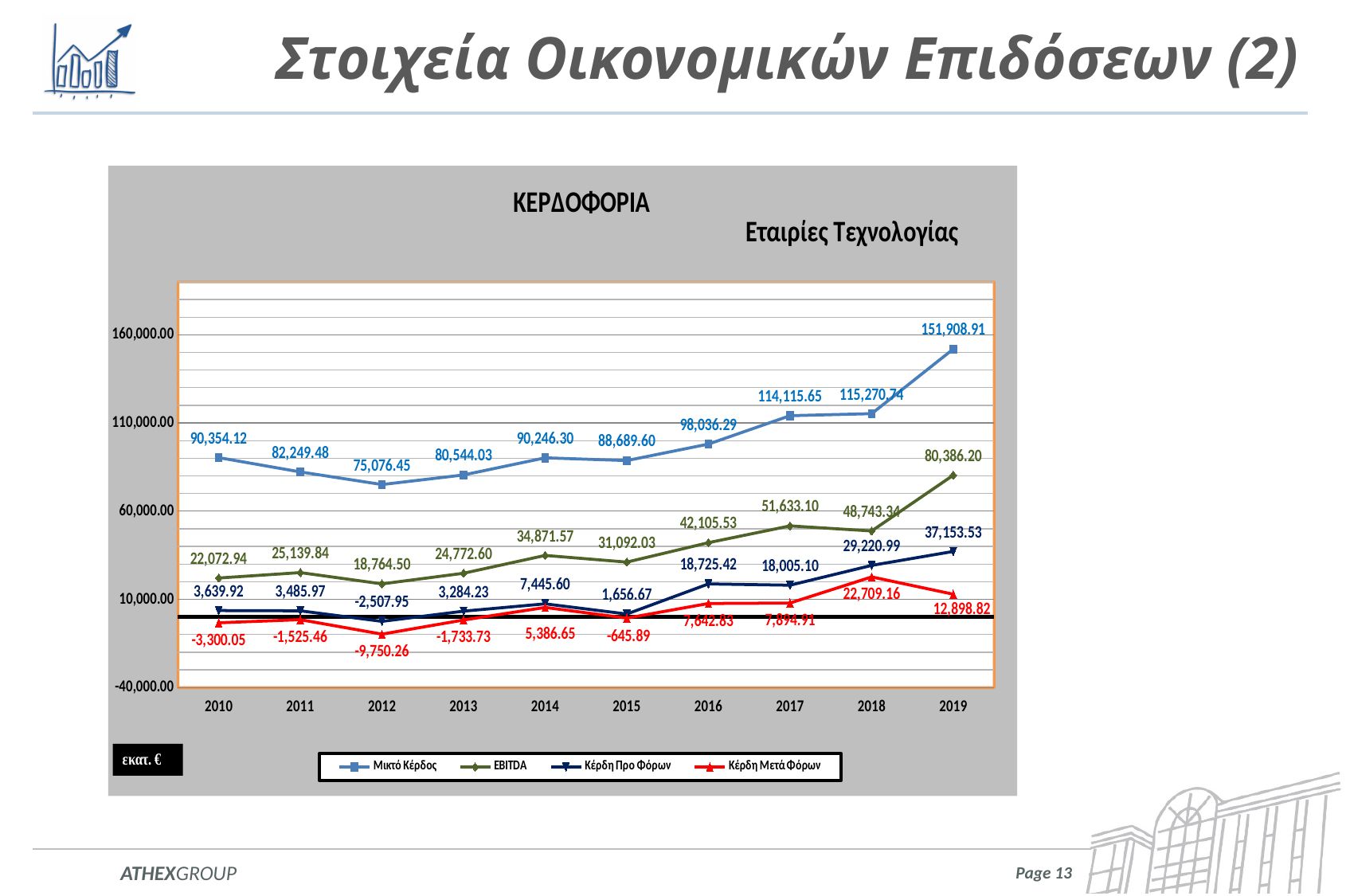
What is the title of the chart? ΚΕΡΔΟΦΟΡΙΑ What is the value of Μικτό Κέρδος in 2019? 151,908.91 What is the value of Κέρδη Μετά Φόρων in 2012? -9,750.26 What is the difference between Μικτό Κέρδος in 2019 and in 2018? 36,638.17 How many series does the legend list? 4 In which year is Κέρδη Μετά Φόρων highest? 2018 What is the EBITDA value for 2014? 34,871.57 Does EBITDA rise or fall from 2018 to 2019? rise What type of chart is shown on the slide? line chart How many years are shown on the x axis? 10 Which is larger in 2017: Κέρδη Προ Φόρων or Κέρδη Μετά Φόρων? Κέρδη Προ Φόρων In which year is Μικτό Κέρδος lowest? 2012